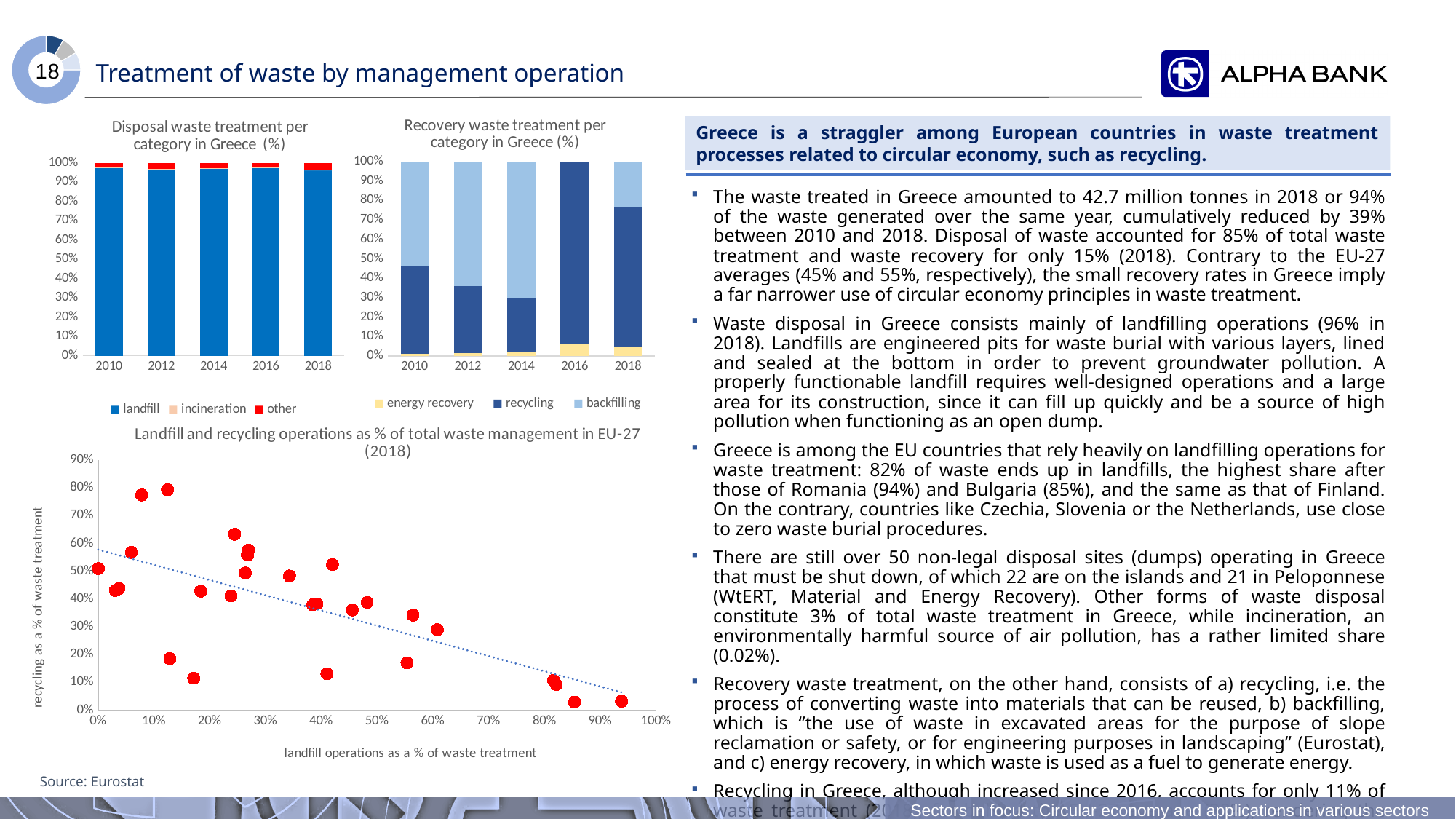
In the 'Disposal waste treatment per category in Greece (%)' chart, which series does the legend list first? landfill In the 'Disposal waste treatment per category in Greece (%)' chart, how many years are shown on the x axis? 5 In the 'Recovery waste treatment per category in Greece (%)' chart, is the recycling share in 2016 greater or less than 90%? greater How many series does the legend of the 'Recovery waste treatment per category in Greece (%)' chart list? 3 In the 'Disposal waste treatment per category in Greece (%)' chart, is the landfill share in 2018 greater or less than 90%? greater What kind of chart is the 'Disposal waste treatment per category in Greece (%)' chart? Stacked bar chart In the 'Landfill and recycling operations as % of total waste management in EU-27 (2018)' chart, does recycling tend to rise or fall as landfill operations increase along the x axis? fall In the 'Recovery waste treatment per category in Greece (%)' chart, is the energy recovery share in 2016 greater or less than 10%? less In the 'Recovery waste treatment per category in Greece (%)' chart, which year has the largest recycling share? 2016 In the 'Recovery waste treatment per category in Greece (%)' chart, does the recycling share rise or fall from 2010 to 2014? fall What kind of chart is the 'Landfill and recycling operations as % of total waste management in EU-27 (2018)' chart? Scatter chart